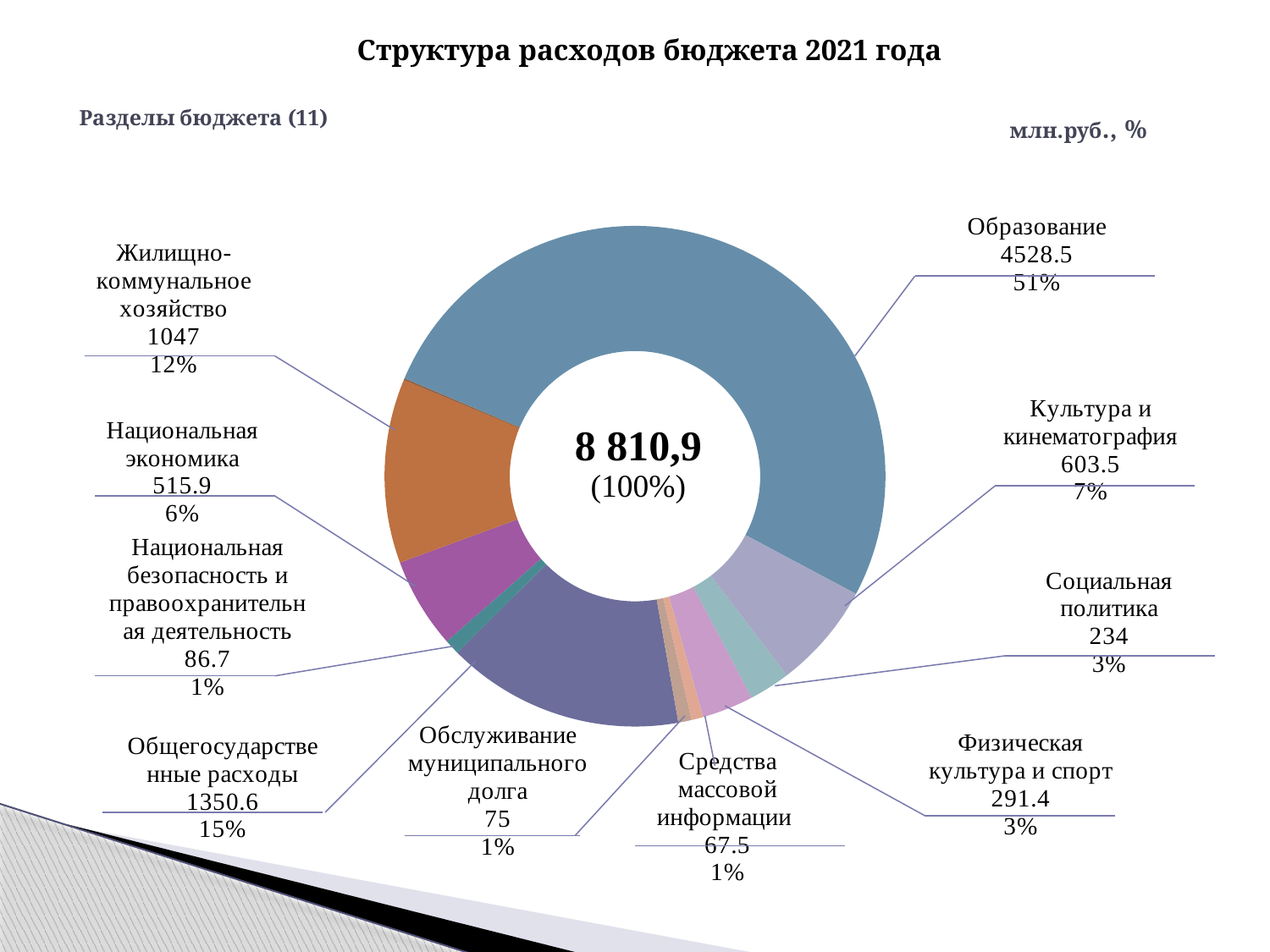
What percentage is shown for Общегосударственные расходы? 15% What type of chart is shown on the slide? doughnut (pie) chart Which is larger: Культура и кинематография or Национальная экономика? Культура и кинематография What is the value for Образование? 4528.5 Which budget section has the largest share? Образование What is the value for Жилищно-коммунальное хозяйство? 1047 What share of the budget does Образование account for? 51% What is the value for Физическая культура и спорт? 291.4 What is the title of the chart? Разделы бюджета (11) What total value is shown in the centre of the chart? 8 810,9 What is the difference between the values for Общегосударственные расходы and Жилищно-коммунальное хозяйство? 303.6